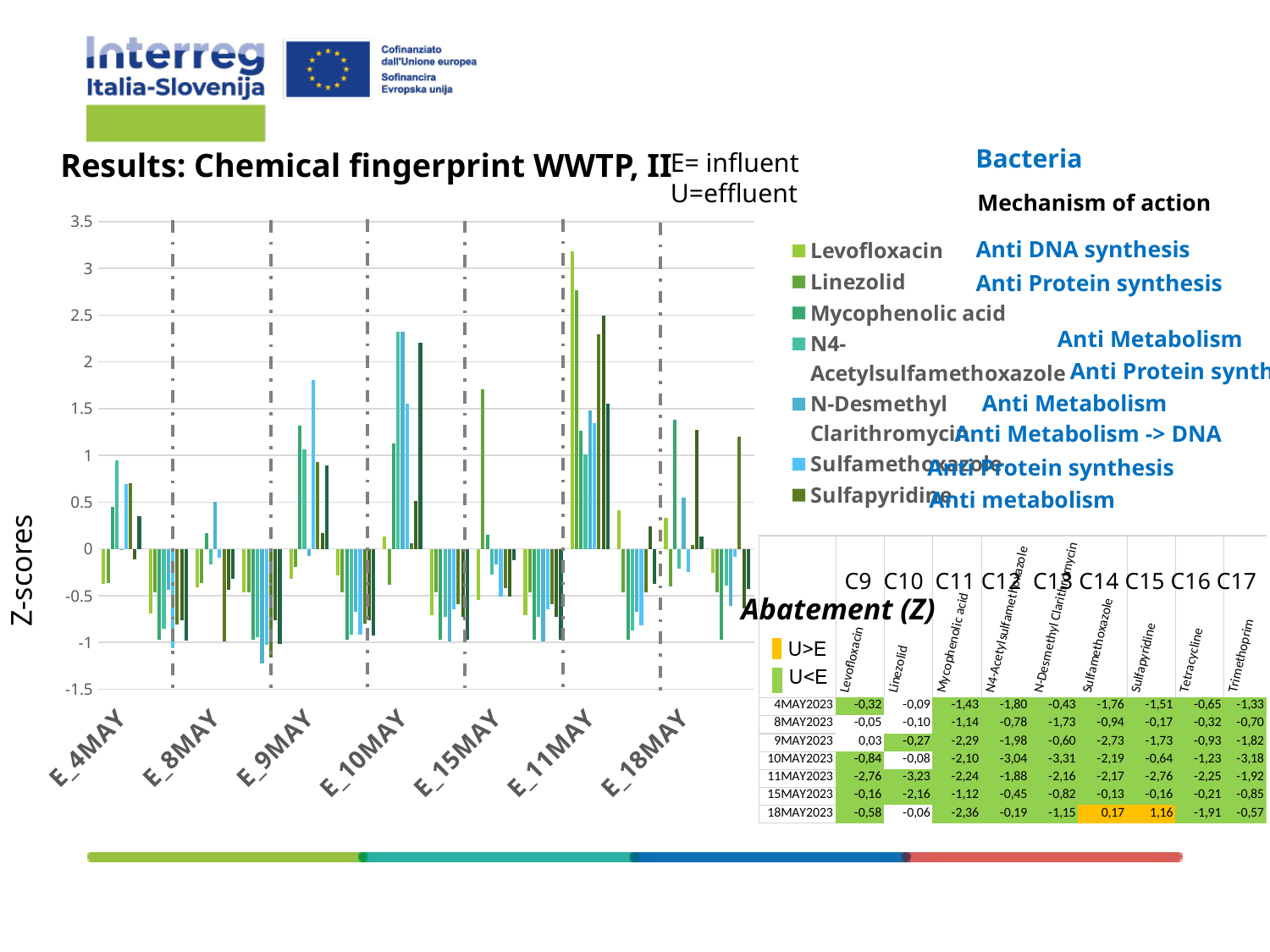
Is the tallest bar in the E_18MAY group greater or less than 1? greater Is the tallest bar in the E_4MAY group greater or less than 1.5? less Is the tallest bar in the E_10MAY group greater or less than 2? greater What is the first category on the x axis of the bar chart? E_4MAY How many categories are shown along the x axis of the bar chart? 7 Which category contains the tallest bar in the chart? E_11MAY What is the last category on the x axis of the bar chart? E_18MAY What is the maximum value shown on the y axis of the bar chart? 3.5 What kind of chart is shown on the slide? bar chart What is the label of the y axis of the bar chart? Z-scores How many series does the legend of the bar chart list? 7